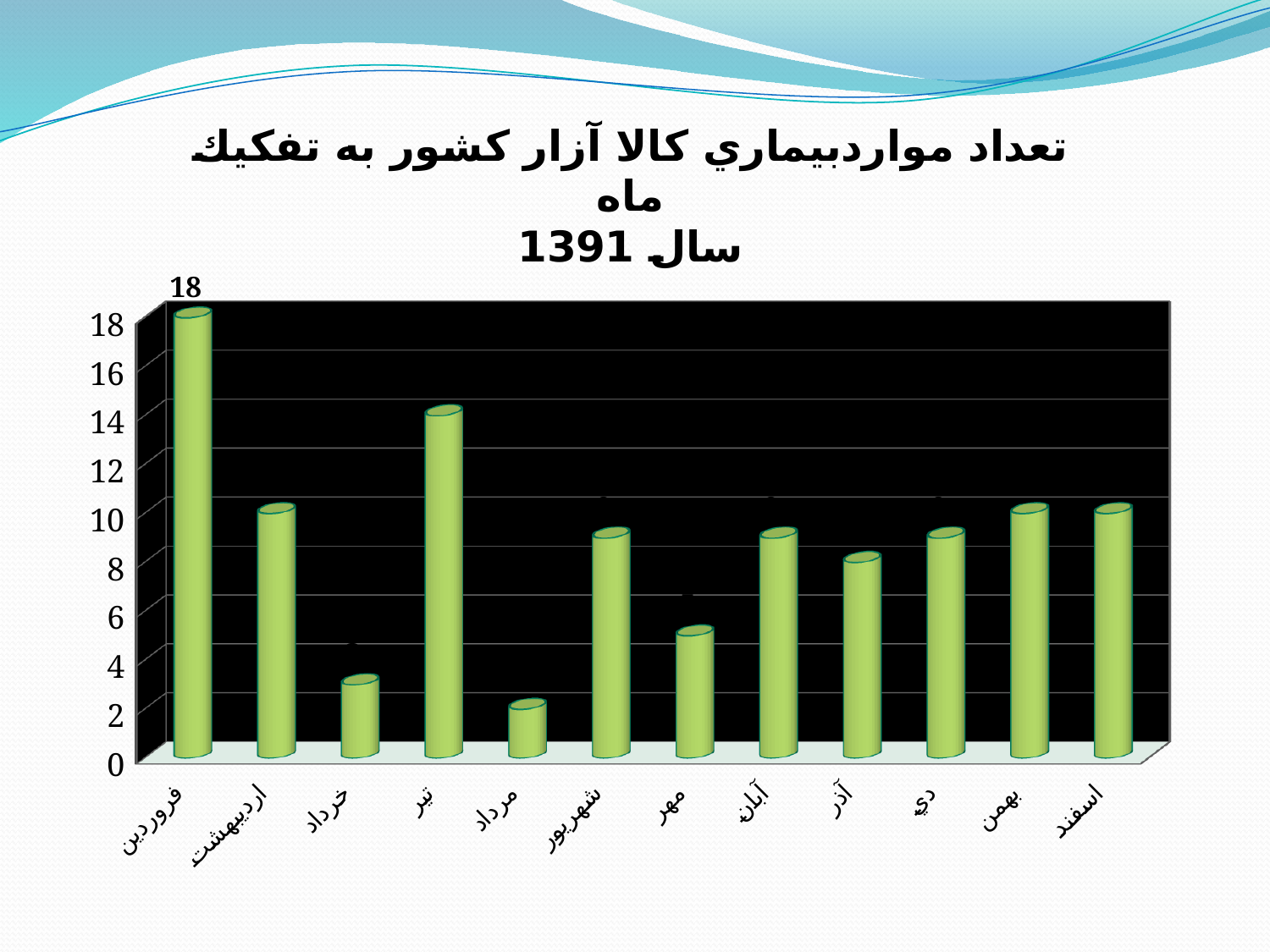
Which is larger, the value for خرداد or the value for مهر? مهر Is the value for مهر greater or less than 6? less Which month has the lowest value? مرداد What kind of chart is shown on the slide? bar chart What is the value for فروردین? 18 How many months are shown on the x axis? 12 Is the value for خرداد greater or less than 4? less Which month has the highest value? فروردین Is the value for اردیبهشت greater or less than 8? greater Which is larger, the value for تیر or the value for اردیبهشت? تیر Which year is named in the chart title? 1391